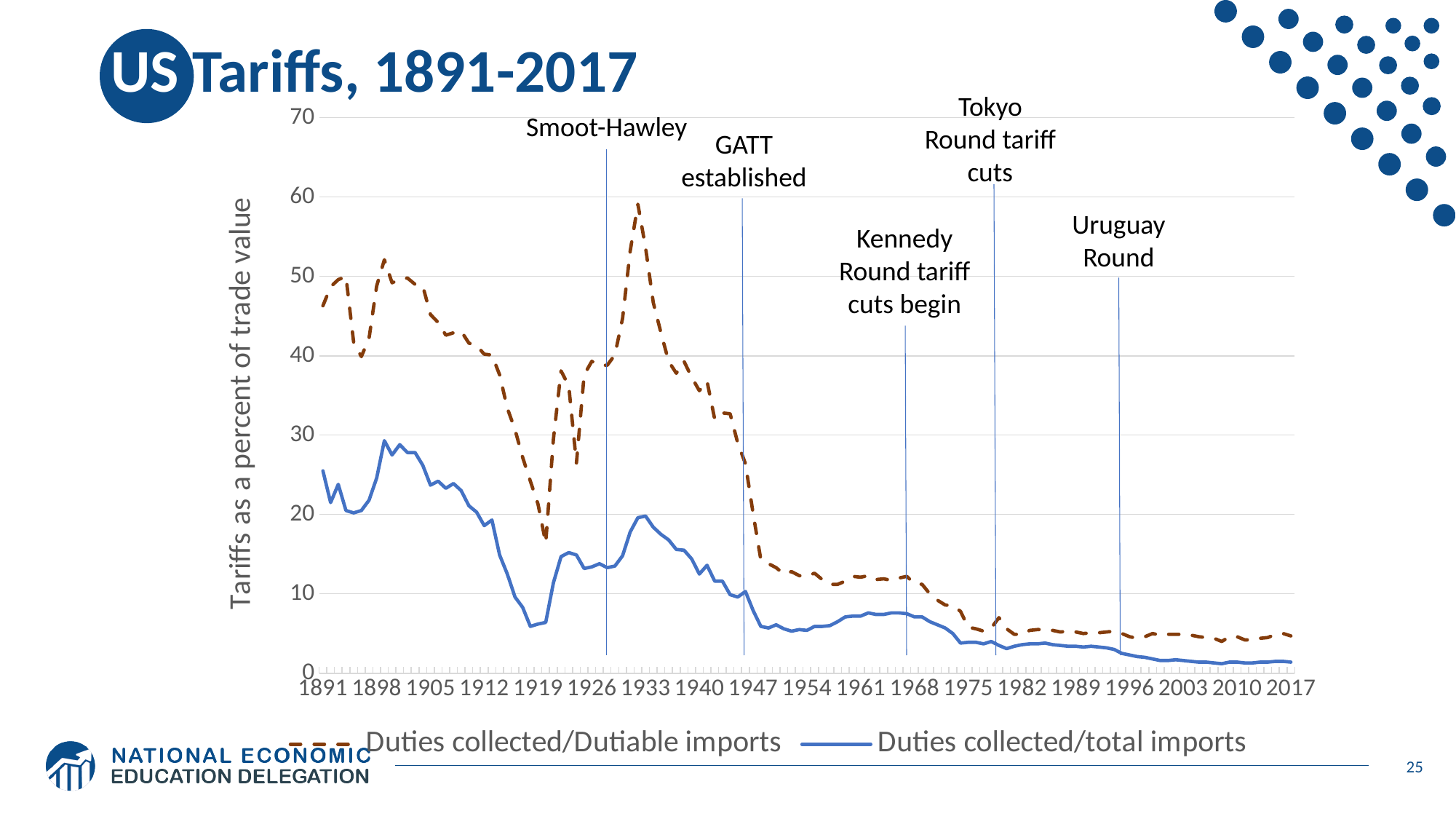
Which series reaches the highest value anywhere on the chart? Duties collected/Dutiable imports What kind of chart is shown on the slide? line chart Is the value for Duties collected/Dutiable imports in 1891 greater or less than 40? greater What is the label on the vertical axis? Tariffs as a percent of trade value What are the two series named in the legend? Duties collected/Dutiable imports; Duties collected/total imports How many series does the legend list? 2 Is the value for Duties collected/Dutiable imports in 1954 greater or less than 20? less Is the value for Duties collected/total imports in 1919 greater or less than 10? less Which series is higher in 1933, Duties collected/Dutiable imports or Duties collected/total imports? Duties collected/Dutiable imports From 1947 to 2017, does the Duties collected/total imports series generally rise or fall? fall